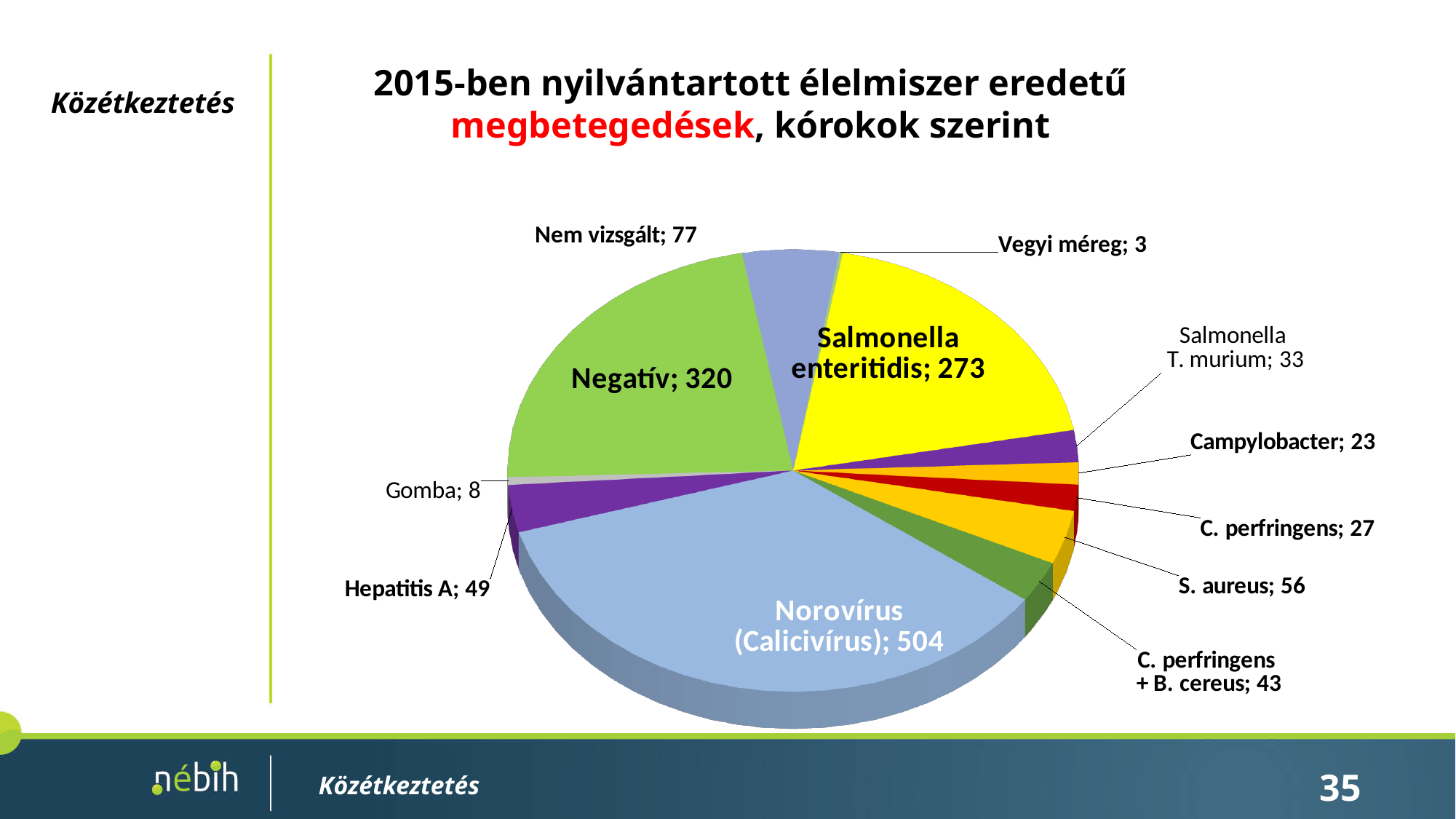
What is the value for Salmonella enteritidis? 273 Which category has the largest slice of the pie? Norovírus (Calicivírus) What is the value for Vegyi méreg? 3 Which is larger, the value for Campylobacter or the value for C. perfringens? C. perfringens How many categories (slices) does the pie chart have? 12 What is the difference between the values for Negatív and Salmonella enteritidis? 47 Which category has the smallest slice of the pie? Vegyi méreg What is the value for Hepatitis A? 49 What is the difference between the values for Nem vizsgált and S. aureus? 21 What is the value for Norovírus (Calicivírus)? 504 What kind of chart is shown on the slide? Pie chart What is the title of the chart on the slide? 2015-ben nyilvántartott élelmiszer eredetű megbetegedések, kórokok szerint